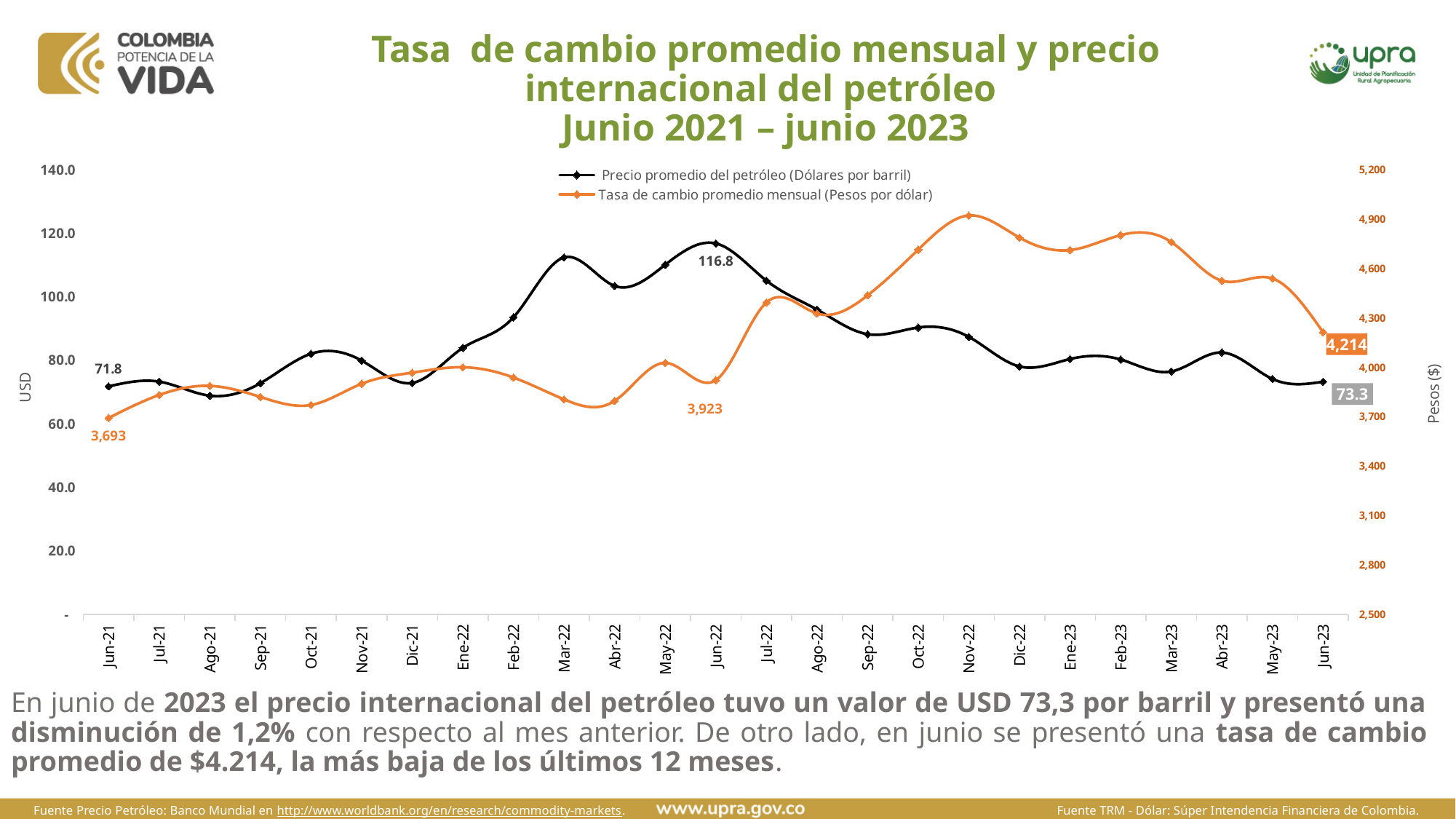
By how much did the average oil price fall from Jun-22 (116.8) to Jun-23 (73.3)? 43.5 What is the average oil price shown for Jun-22? 116.8 In which month does the oil price series reach its highest value? Jun-22 What kind of chart is shown on the slide? Line chart In which month does the exchange rate series reach its highest value? Nov-22 Is the oil price for Mar-22 greater or less than 100.0? greater How many series does the legend list? 2 What is the average oil price shown for Jun-23? 73.3 What is the monthly average exchange rate shown for Jun-23? 4,214 What is the difference between the exchange rate in Jun-23 (4,214) and in Jun-21 (3,693)? 521 What is the average oil price (Precio promedio del petróleo) shown for Jun-21? 71.8 What is the monthly average exchange rate (Tasa de cambio promedio mensual) shown for Jun-21? 3,693